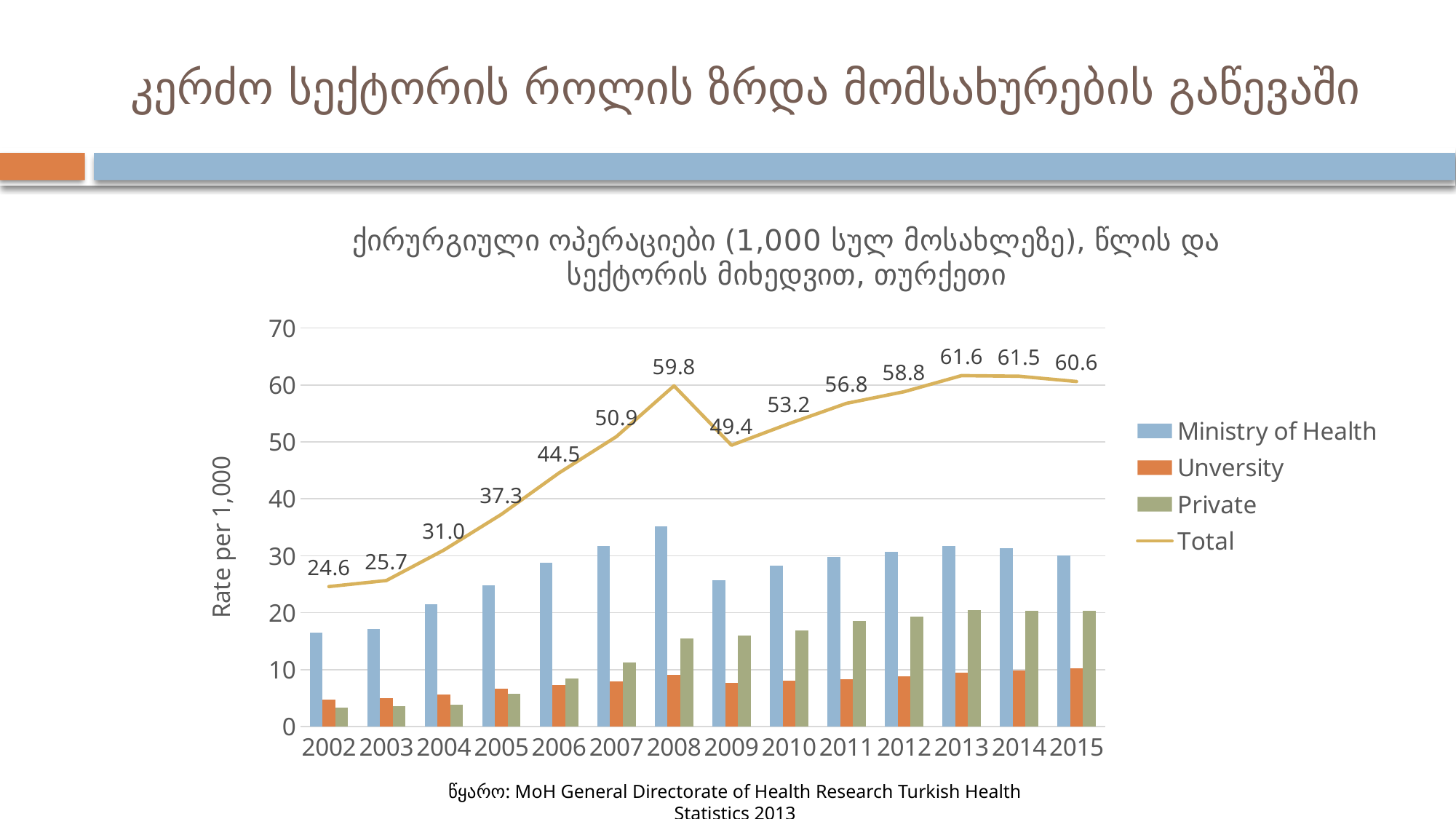
What is the Total value for 2002? 24.6 Is the Ministry of Health value for 2008 greater or less than 30? greater How many series does the legend list? 4 Is the Private value for 2002 greater or less than 10? less In which year is the Total value highest? 2013 What is the Total value for 2008? 59.8 Is the Total value for 2008 larger than the Total value for 2009? Yes In which year is the Total value lowest? 2002 What is the Total value for 2015? 60.6 How many years are shown on the x axis? 14 What is the difference between the Total values for 2008 and 2009? 10.4 Does the Total value rise or fall from 2002 to 2008? rise